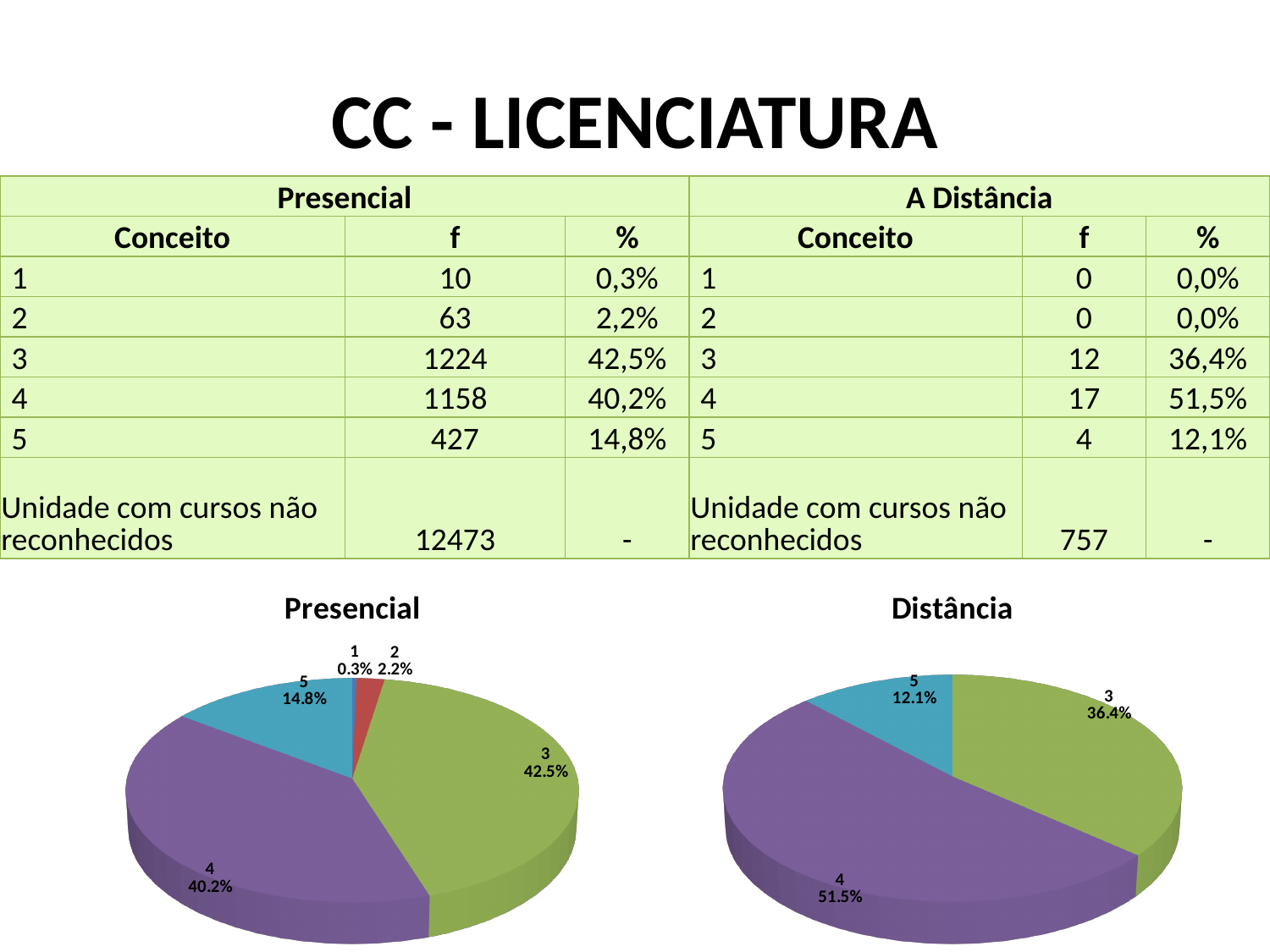
How many slices are labelled in the Distância pie chart? 3 In the Presencial pie chart, what share does conceito 5 have? 14.8% In the Distância pie chart, what share does conceito 4 have? 51.5% In the Distância pie chart, what share does conceito 3 have? 36.4% In the Presencial pie chart, what share does conceito 3 have? 42.5% In the Distância pie chart, what is the difference between the shares of conceito 4 and conceito 3? 15.1% In the Presencial pie chart, which conceito has the largest slice? 3 How many slices are labelled in the Presencial pie chart? 5 In the Distância pie chart, which conceito has the smallest slice? 5 What type of chart is the Presencial chart? Pie chart In the Presencial pie chart, which is larger, the slice for conceito 4 or the slice for conceito 5? 4 In the Presencial pie chart, which conceito has the smallest slice? 1